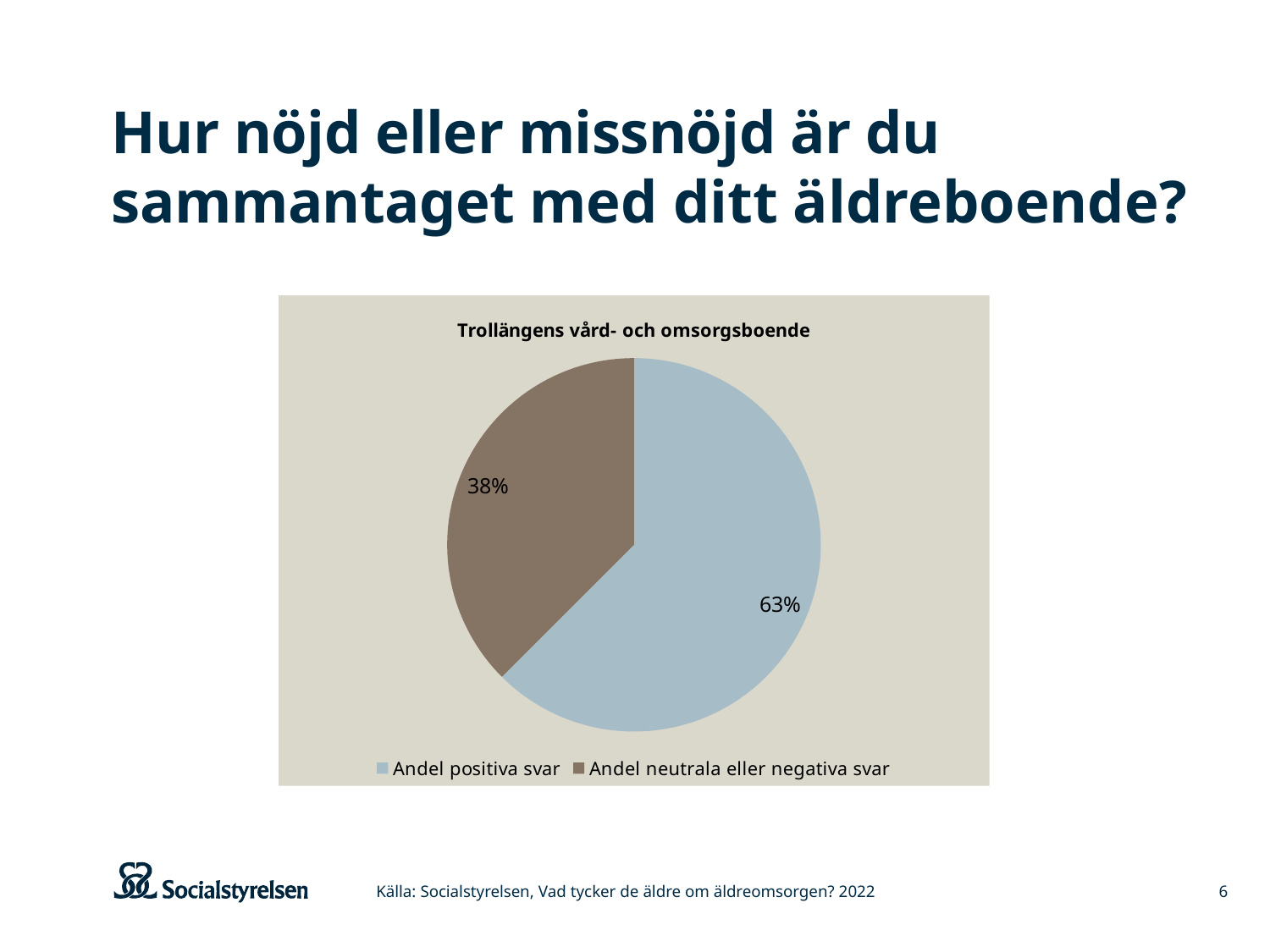
What is the difference in percentage points between 'Andel positiva svar' and 'Andel neutrala eller negativa svar'? 25 What share of the pie is 'Andel positiva svar'? 63% What is the title of the chart? Trollängens vård- och omsorgsboende What share of the pie is 'Andel neutrala eller negativa svar'? 38% How many entries does the legend list? 2 Which slice is the smallest in the pie chart? Andel neutrala eller negativa svar What kind of chart is shown on the slide? Pie chart Which slice is the largest in the pie chart? Andel positiva svar Which legend entry is shown in the brown colour? Andel neutrala eller negativa svar Which is larger: 'Andel positiva svar' or 'Andel neutrala eller negativa svar'? Andel positiva svar How many slices does the pie chart have? 2